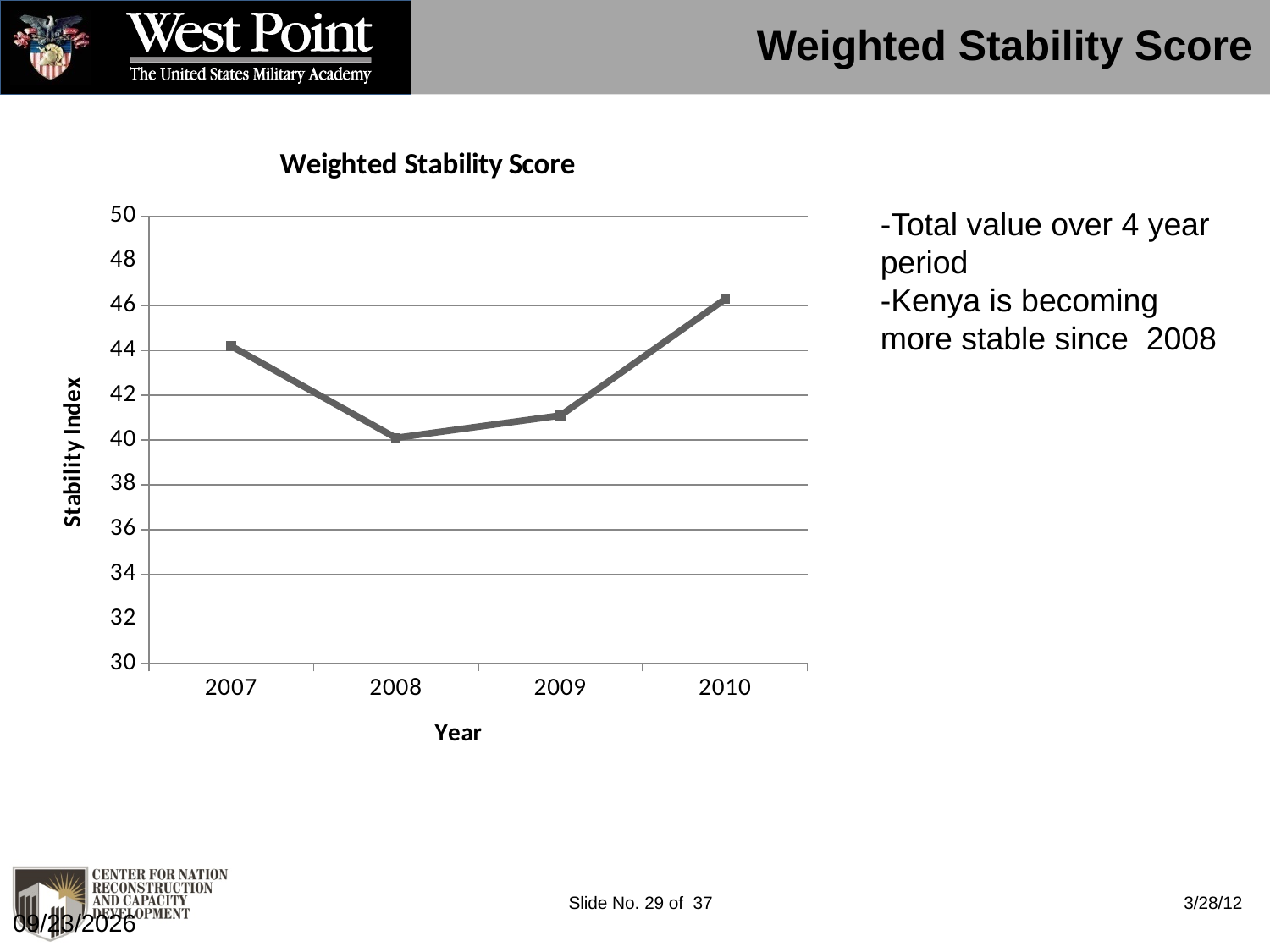
Which year has the lowest Stability Index value? 2008 Is the value for 2010 greater or less than 44? greater Which year has the highest Stability Index value? 2010 What is the title of the chart? Weighted Stability Score Is the value for 2008 greater or less than 42? less What kind of chart is shown on the slide? line chart Which year has the larger Stability Index value, 2008 or 2009? 2009 How many years are plotted on the x axis of the chart? 4 Is the value for 2007 greater or less than 42? greater Which year has the larger Stability Index value, 2007 or 2010? 2010 Does the Stability Index rise or fall from 2008 to 2010? rise What is the label on the vertical axis of the chart? Stability Index